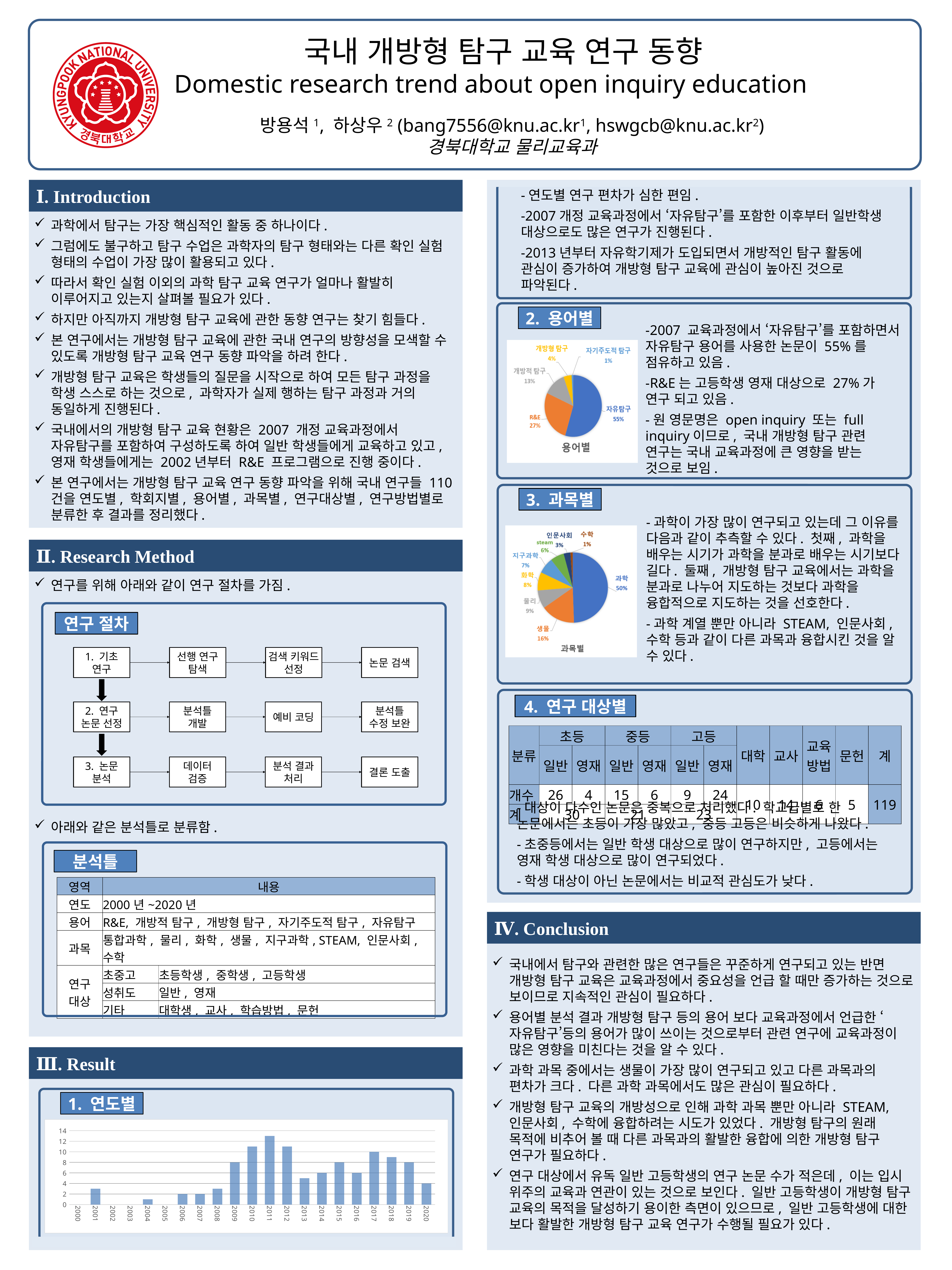
What kind of chart is the chart titled 1. 연도별? bar chart In the pie chart titled 용어별, how many slices are there? 5 In the bar chart titled 1. 연도별, which year has the highest bar? 2011 In the pie chart titled 용어별, what is the difference between the shares of 자유탐구 and R&E? 28% In the pie chart titled 용어별, what share does 자유탐구 have? 55% In the pie chart titled 과목별, what share does 생물 have? 16% In the pie chart titled 과목별, which is larger, the share of 화학 or the share of 지구과학? 화학 In the pie chart titled 용어별, which term has the smallest share? 자기주도적 탐구 In the pie chart titled 과목별, what is the difference between the shares of 생물 and 물리? 7% In the pie chart titled 용어별, what share does R&E have? 27% In the pie chart titled 과목별, what share does 과학 have? 50% In the bar chart titled 1. 연도별, is the value for 2010 greater or less than 10? greater